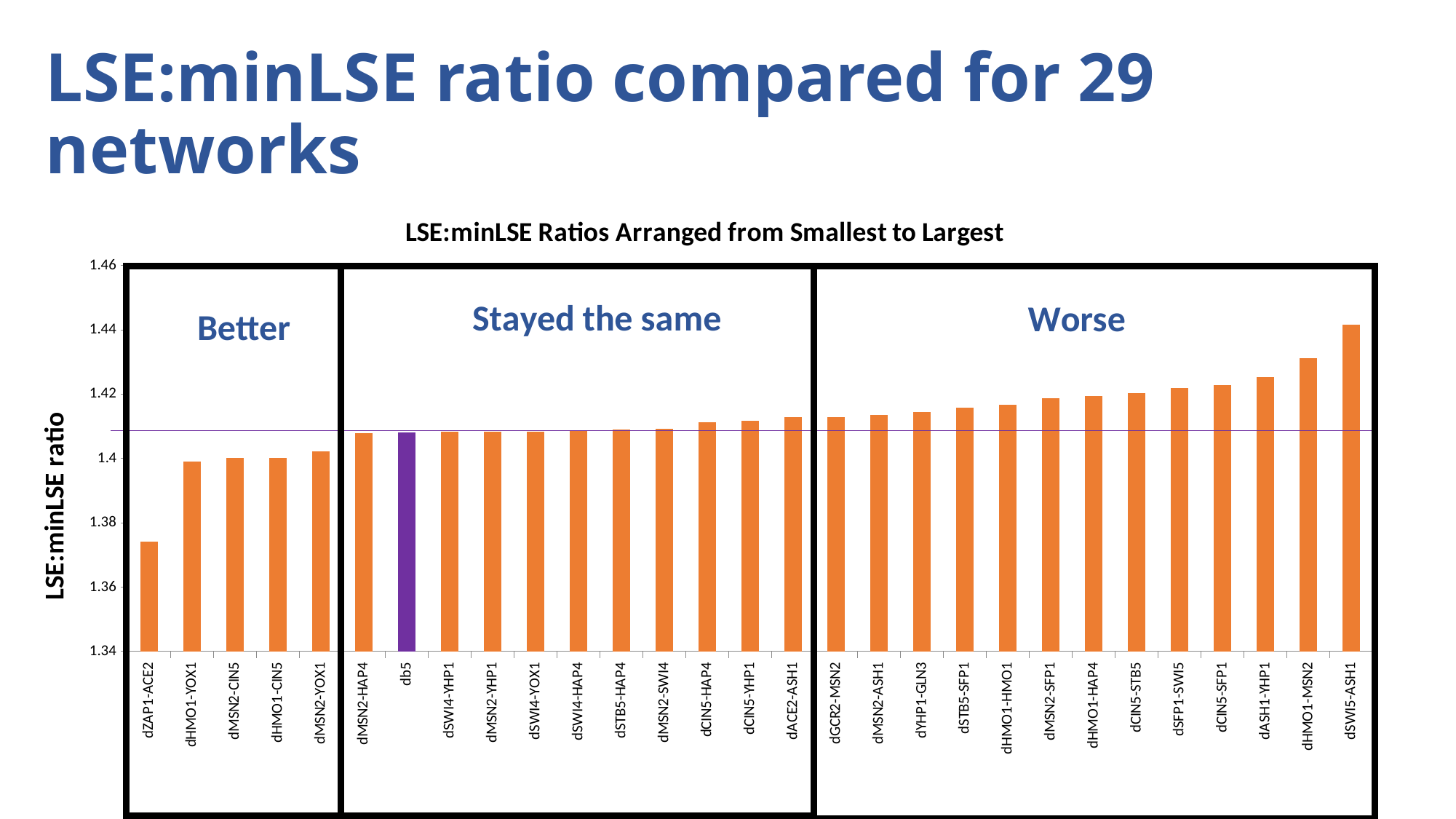
Is the LSE:minLSE ratio for dHMO1-MSN2 greater or less than 1.42? greater What kind of chart is shown on the slide? Bar chart Do the LSE:minLSE ratios rise or fall from left to right along the x axis? Rise Which network has the highest LSE:minLSE ratio? dSWI5-ASH1 How many bars are in the group labelled "Better"? 5 Which network has the lowest LSE:minLSE ratio? dZAP1-ACE2 Which network's bar is coloured purple instead of orange? db5 How many networks (bars) are plotted in the chart? 29 Is the LSE:minLSE ratio for dZAP1-ACE2 greater or less than 1.38? less Which has the larger LSE:minLSE ratio, dHMO1-MSN2 or dASH1-YHP1? dHMO1-MSN2